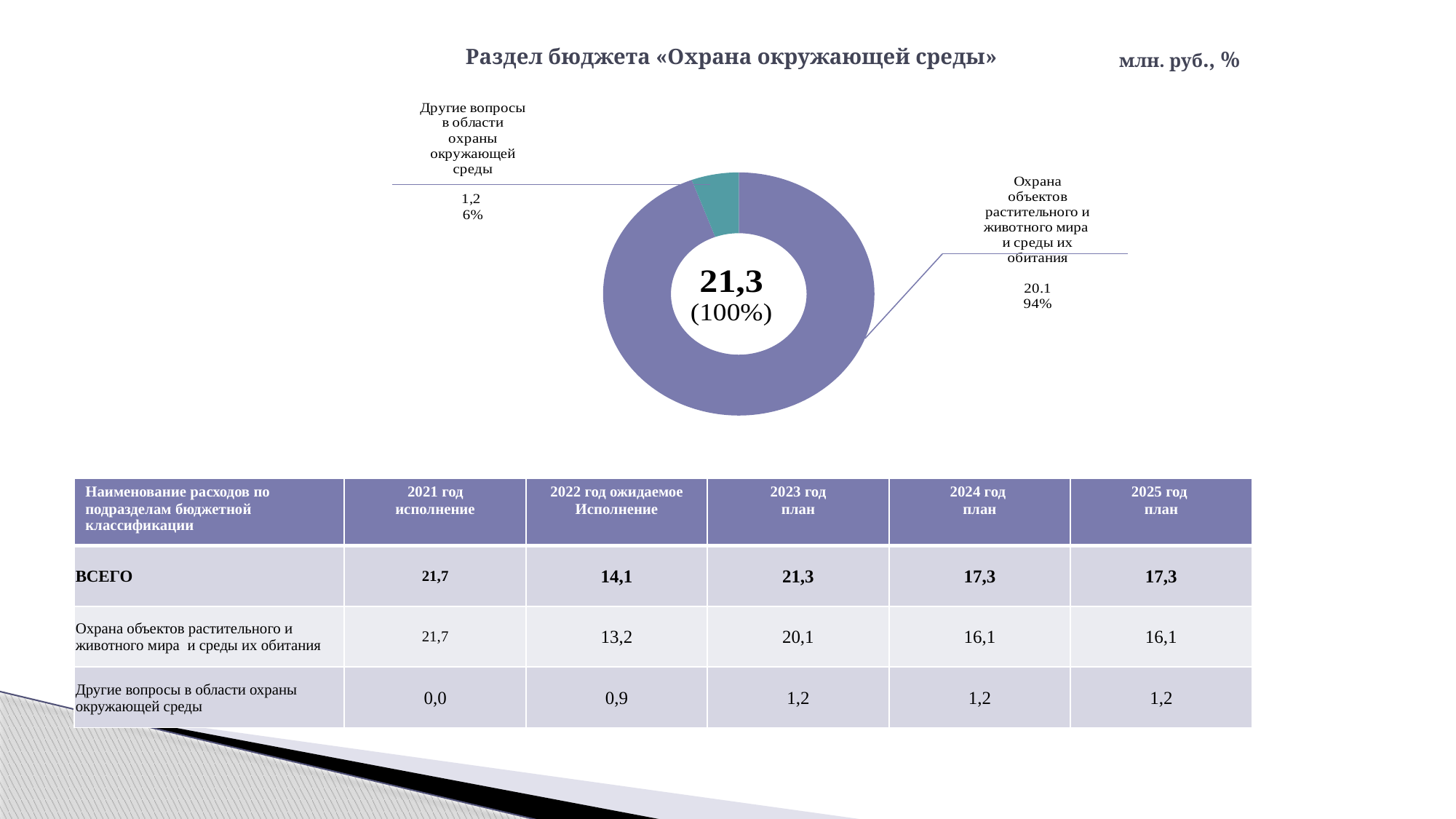
What value is shown for «Другие вопросы в области охраны окружающей среды»? 1,2 Which slice is the smallest in the donut chart? Другие вопросы в области охраны окружающей среды Which slice is the largest in the donut chart? Охрана объектов растительного и животного мира и среды их обитания What share of the donut does «Другие вопросы в области охраны окружающей среды» represent? 6% What kind of chart is shown on the slide? Donut (pie) chart What units are indicated for the chart in the top right corner? млн. руб., % What total value is shown in the centre of the donut chart? 21,3 (100%) Which is larger: the value for «Охрана объектов растительного и животного мира и среды их обитания» or for «Другие вопросы в области охраны окружающей среды»? Охрана объектов растительного и животного мира и среды их обитания What is the title of the chart? Раздел бюджета «Охрана окружающей среды» What share of the donut does «Охрана объектов растительного и животного мира и среды их обитания» represent? 94% What value is shown for «Охрана объектов растительного и животного мира и среды их обитания»? 20.1 How many slices does the donut chart have? 2